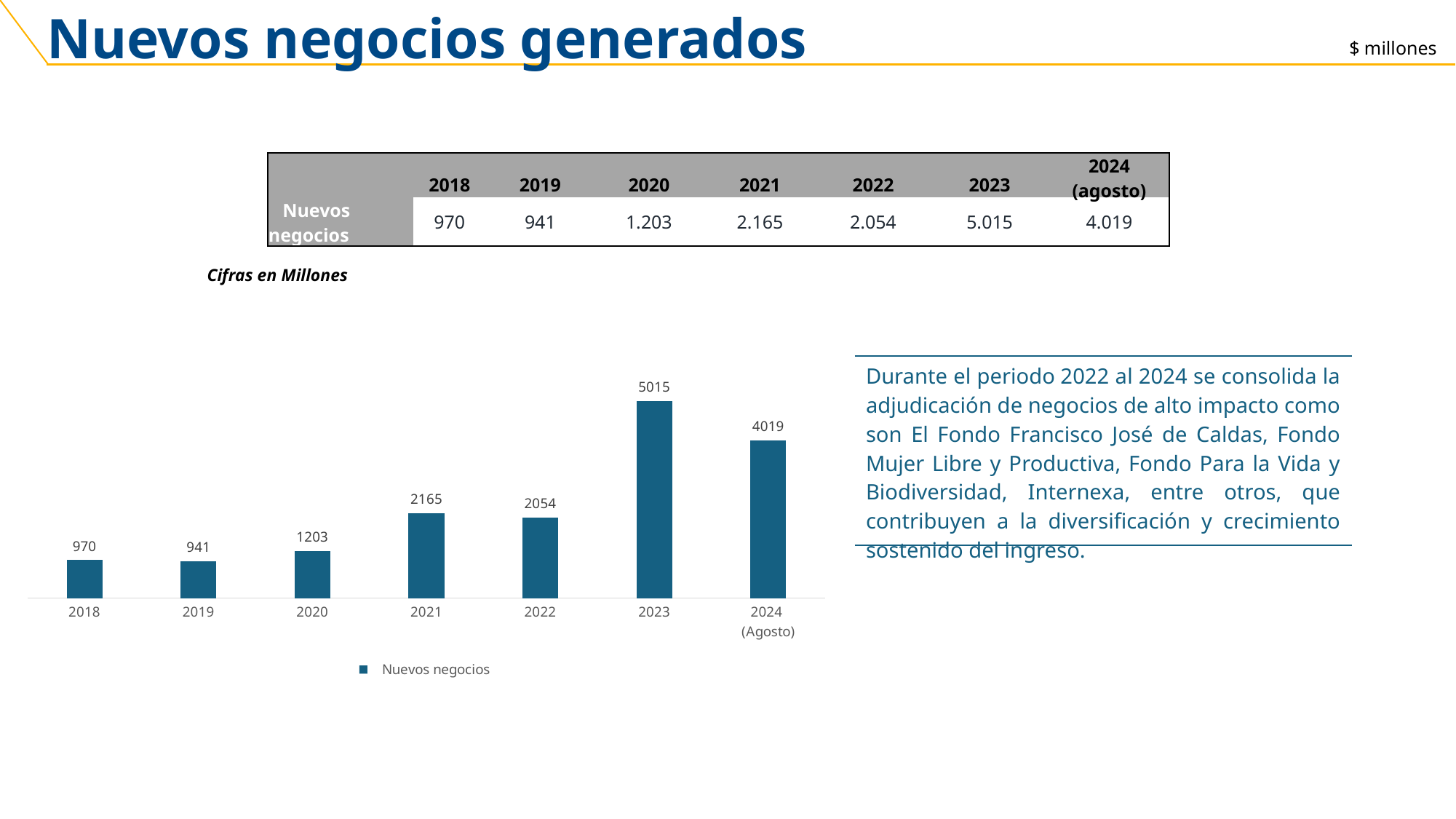
What is the difference between the values for 2023 and 2024 (Agosto)? 996 What is the value for 2018 in the bar chart? 970 How many bars are in the bar chart? 7 Which is larger, the value for 2020 or the value for 2019? 2020 What is the difference between the values for 2021 and 2022? 111 What kind of chart is shown on the slide? bar chart What is the value for 2023 in the bar chart? 5015 Which year has the lowest value in the bar chart? 2019 How many series does the legend list? 1 Which year has the highest value in the bar chart? 2023 What is the value for 2024 (Agosto) in the bar chart? 4019 What is the legend entry for the series in the bar chart? Nuevos negocios